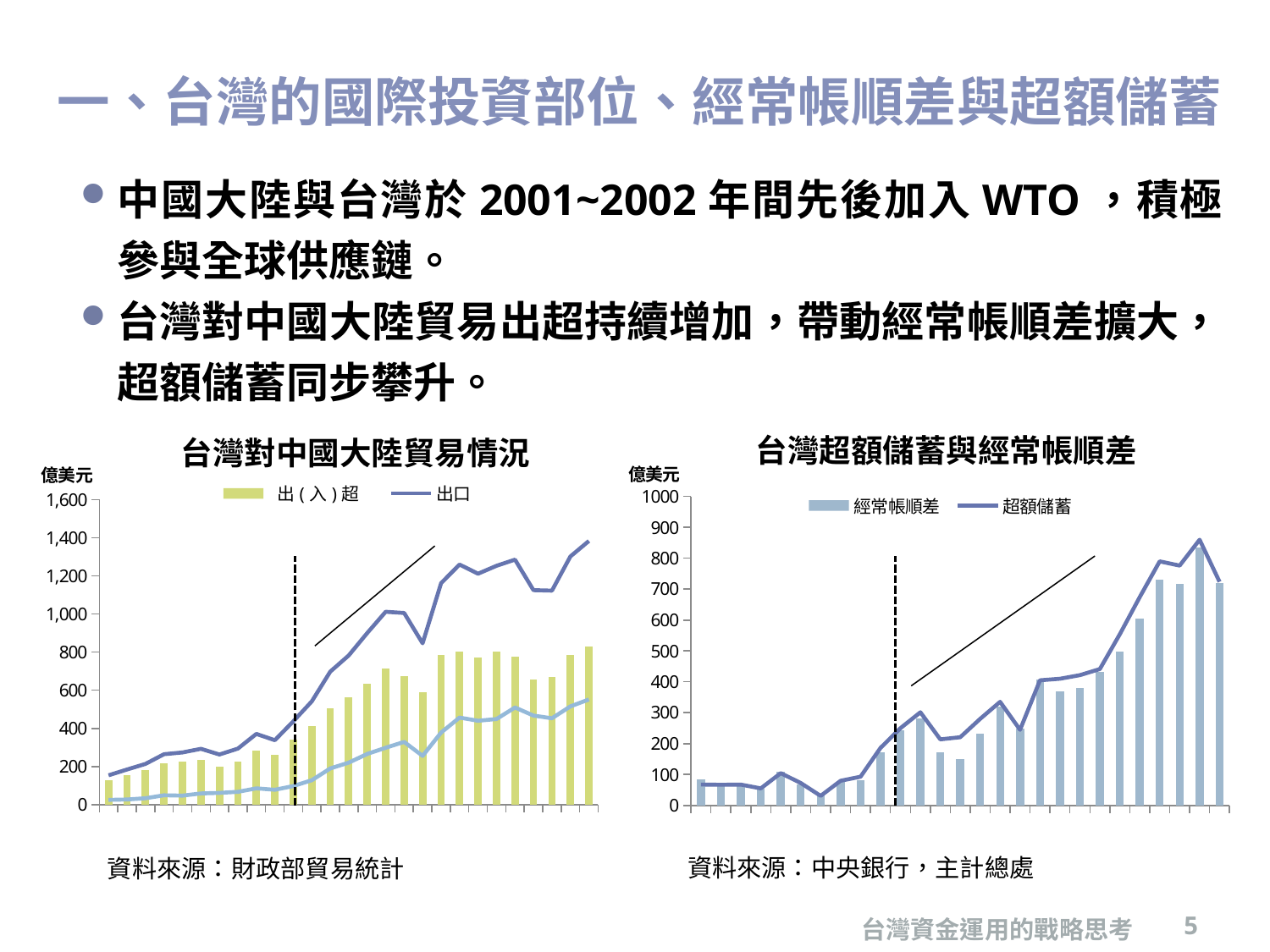
How many series does the legend of the right chart 台灣超額儲蓄與經常帳順差 list? 2 In the left chart 台灣對中國大陸貿易情況, is the highest value of the 出口 line greater or less than 1,200? greater In the left chart 台灣對中國大陸貿易情況, which series is drawn as a line according to the legend? 出口 What kind of chart is the left chart titled 台灣對中國大陸貿易情況? A combined bar and line chart In the right chart 台灣超額儲蓄與經常帳順差, does the 超額儲蓄 line generally rise or fall from left to right? Rise In the left chart 台灣對中國大陸貿易情況, is the tallest 出(入)超 bar greater or less than 600? greater How many series does the legend of the left chart 台灣對中國大陸貿易情況 list? 2 In the right chart 台灣超額儲蓄與經常帳順差, is the tallest 經常帳順差 bar greater or less than 700? greater In the left chart 台灣對中國大陸貿易情況, does the 出口 line generally rise or fall from left to right? Rise In the right chart 台灣超額儲蓄與經常帳順差, which series is drawn as bars? 經常帳順差